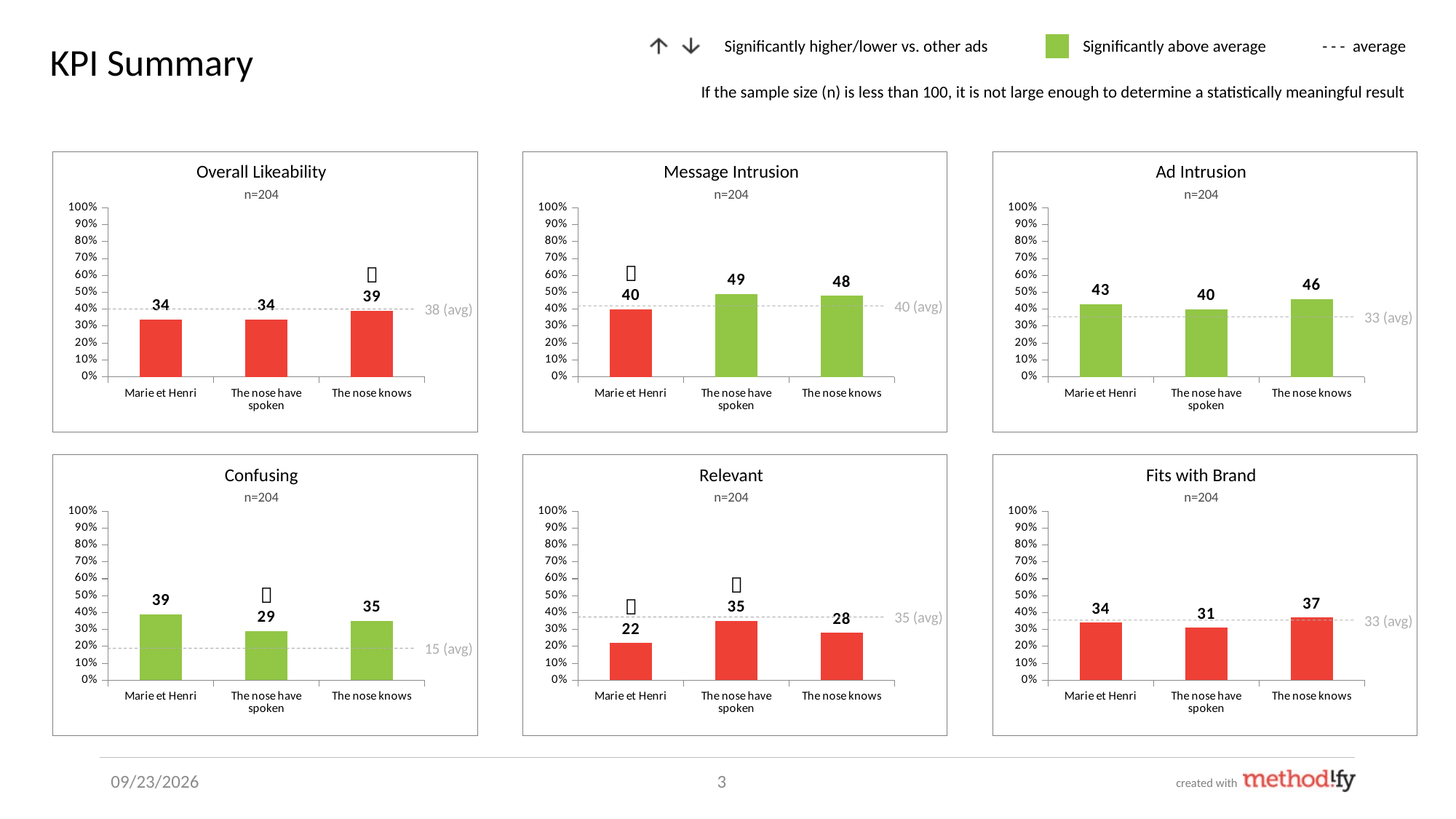
In the Confusing chart, which category has the lowest value? The nose have spoken In the Fits with Brand chart, which is larger, The nose knows or The nose have spoken? The nose knows How many categories are shown in the Confusing chart? 3 What kind of chart is the Relevant chart? bar chart In the Confusing chart, what is the difference between Marie et Henri and The nose knows? 4 In the Ad Intrusion chart, what is the value for Marie et Henri? 43 What is the sample size (n) shown under the Fits with Brand chart title? n=204 In the Overall Likeability chart, what is the value for The nose knows? 39 In the Message Intrusion chart, is the value for The nose knows greater or less than 40%? greater In the Message Intrusion chart, which category has the highest value? The nose have spoken In the Ad Intrusion chart, what is the average value shown by the dashed line? 33 (avg) In the Relevant chart, what is the difference between The nose have spoken and Marie et Henri? 13